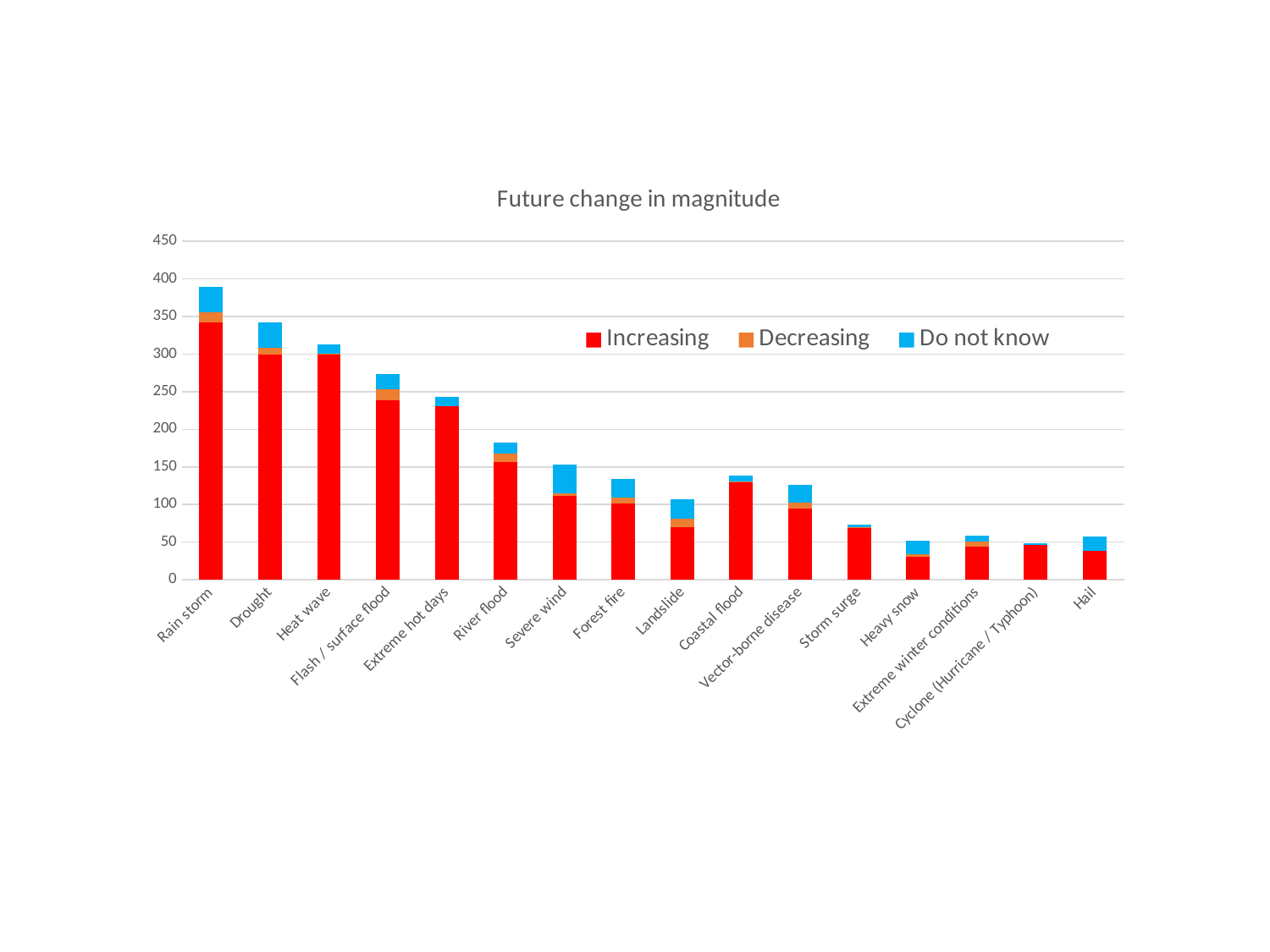
Do the total stacked values generally rise or fall from left to right along the x axis? fall Which category has the highest total stacked bar? Rain storm Is the total stacked value for Flash / surface flood greater or less than 250? greater Is the Increasing value for Extreme hot days greater or less than 250? less What kind of chart is shown on the slide? Stacked bar chart Is the Increasing value for Heavy snow greater or less than 50? less How many series does the legend list? 3 How many categories are shown on the x axis? 16 Which has the larger total stacked bar, Drought or River flood? Drought What is the title of the chart? Future change in magnitude